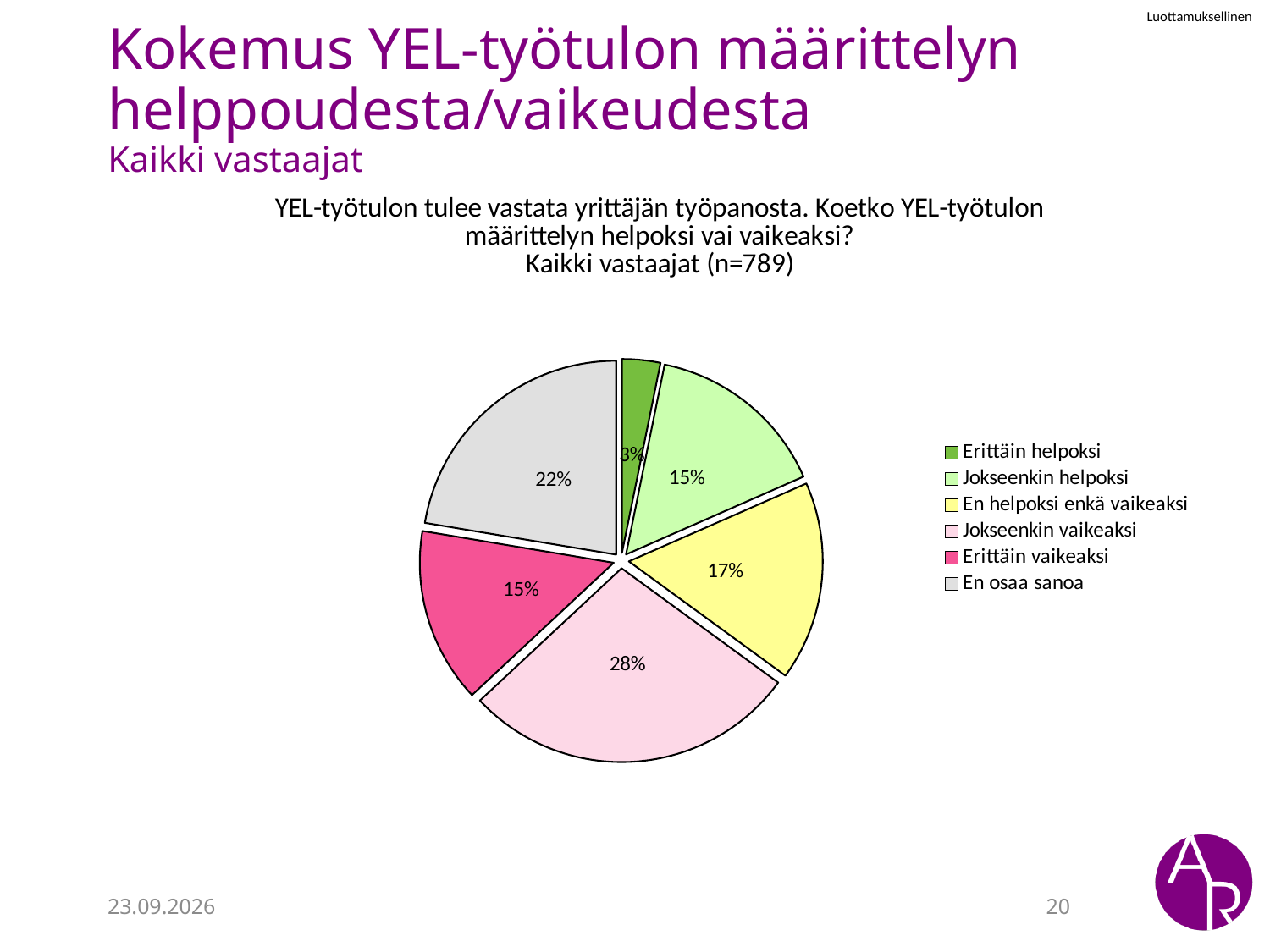
What share of respondents answered "Erittäin helpoksi"? 3% What kind of chart is shown on the slide? pie chart What is the combined share of "Jokseenkin helpoksi" and "Erittäin helpoksi"? 18% Which response category has the smallest share of the pie? Erittäin helpoksi What is the difference in percentage points between "Jokseenkin vaikeaksi" and "En osaa sanoa"? 6 percentage points Which is larger, the share for "En helpoksi enkä vaikeaksi" or the share for "Erittäin vaikeaksi"? En helpoksi enkä vaikeaksi What share of respondents answered "Jokseenkin vaikeaksi"? 28% How many categories does the legend of the pie chart list? 6 What share of respondents answered "En osaa sanoa"? 22% Which response category has the largest share of the pie? Jokseenkin vaikeaksi How many respondents (n) does the chart subtitle state? 789 What share of respondents answered "En helpoksi enkä vaikeaksi"? 17%